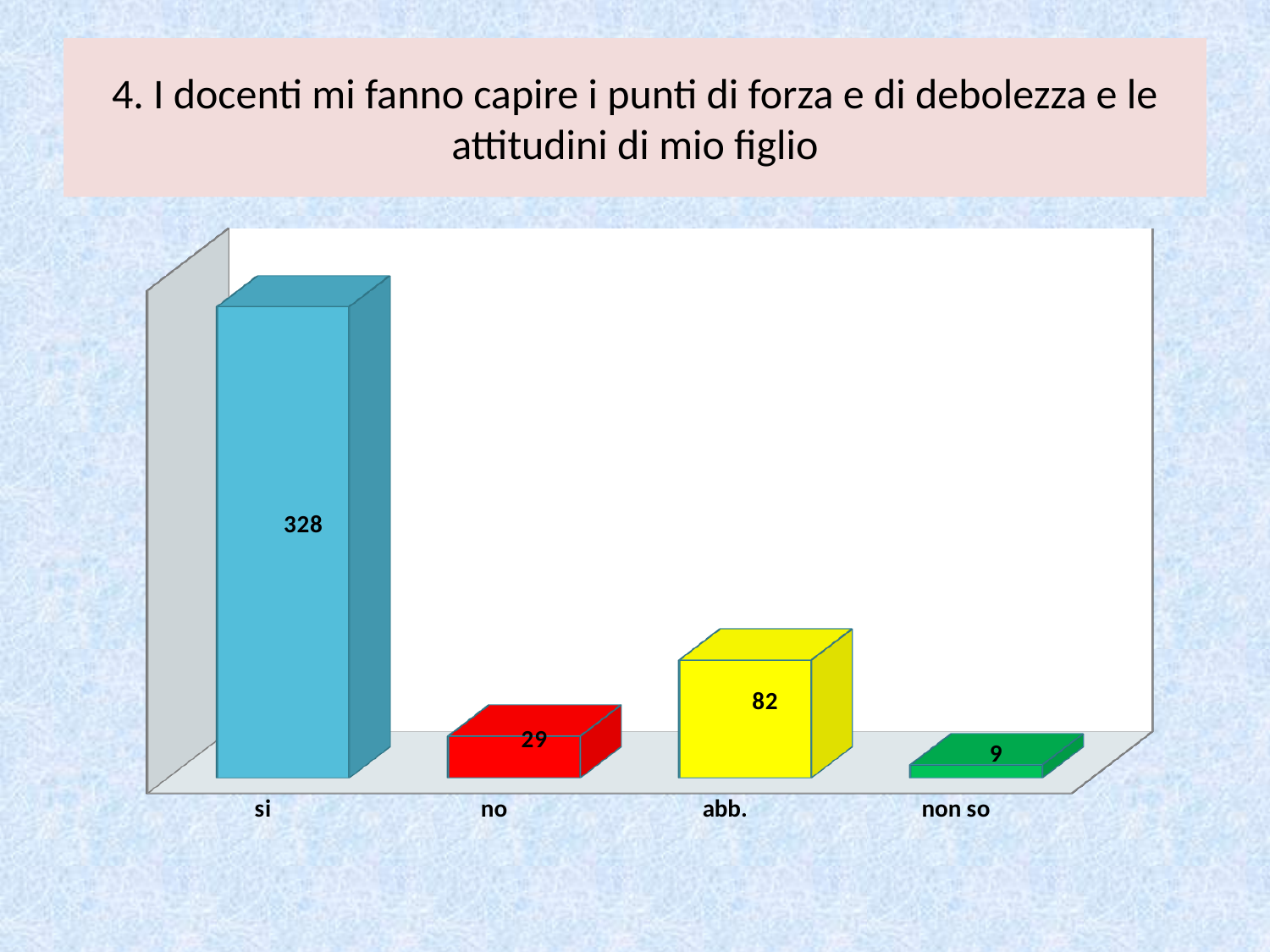
What is the value for "si"? 328 What kind of chart is shown on the slide? bar chart Which category has the highest value? si What is the difference between the values for "si" and "abb."? 246 Which is larger, the value for "no" or the value for "abb."? abb. What is the value for "abb."? 82 What is the difference between the values for "no" and "non so"? 20 What is the value for "non so"? 9 What is the value for "no"? 29 What colour is the bar for "abb."? yellow Which category has the lowest value? non so How many categories are shown on the chart? 4